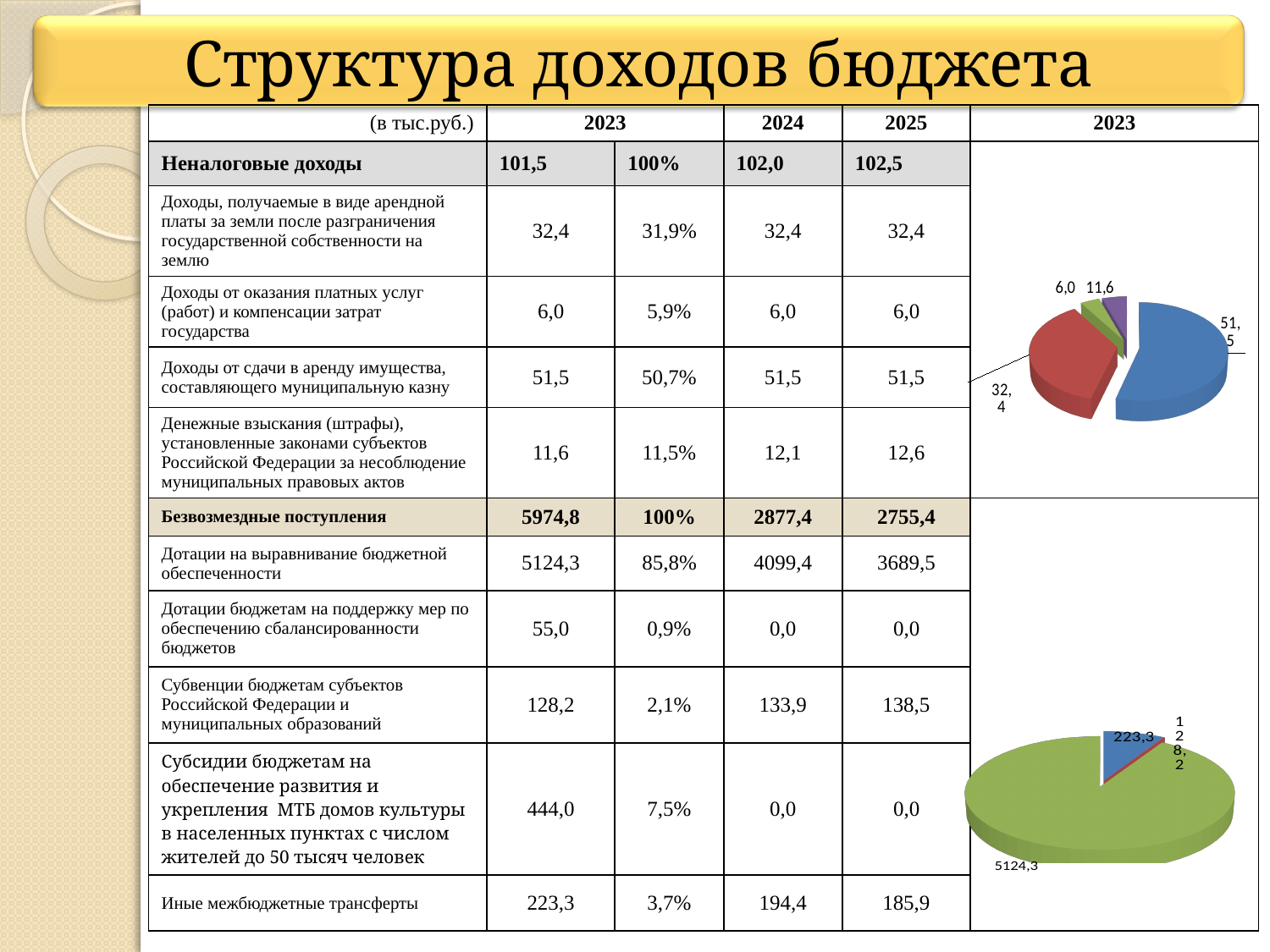
How many slices does the upper pie chart have? 4 In the upper pie chart, which labelled value is the smallest? 6,0 What kind of chart is the upper chart on the right side of the slide? Pie chart How many labelled slices does the lower pie chart have? 3 In the lower pie chart, which labelled value is the smallest? 128,2 In the upper pie chart, which labelled value is the largest? 51,5 In the upper pie chart, what value is labelled on the blue slice? 51,5 In the upper pie chart, what is the total of all four labelled slices? 101,5 In the upper pie chart, is the slice labelled 32,4 larger or smaller than the slice labelled 11,6? larger In the lower pie chart, what value is labelled on the large green slice? 5124,3 What year is shown in the header above the upper pie chart? 2023 In the upper pie chart, what is the difference between the slice labelled 51,5 and the slice labelled 32,4? 19,1